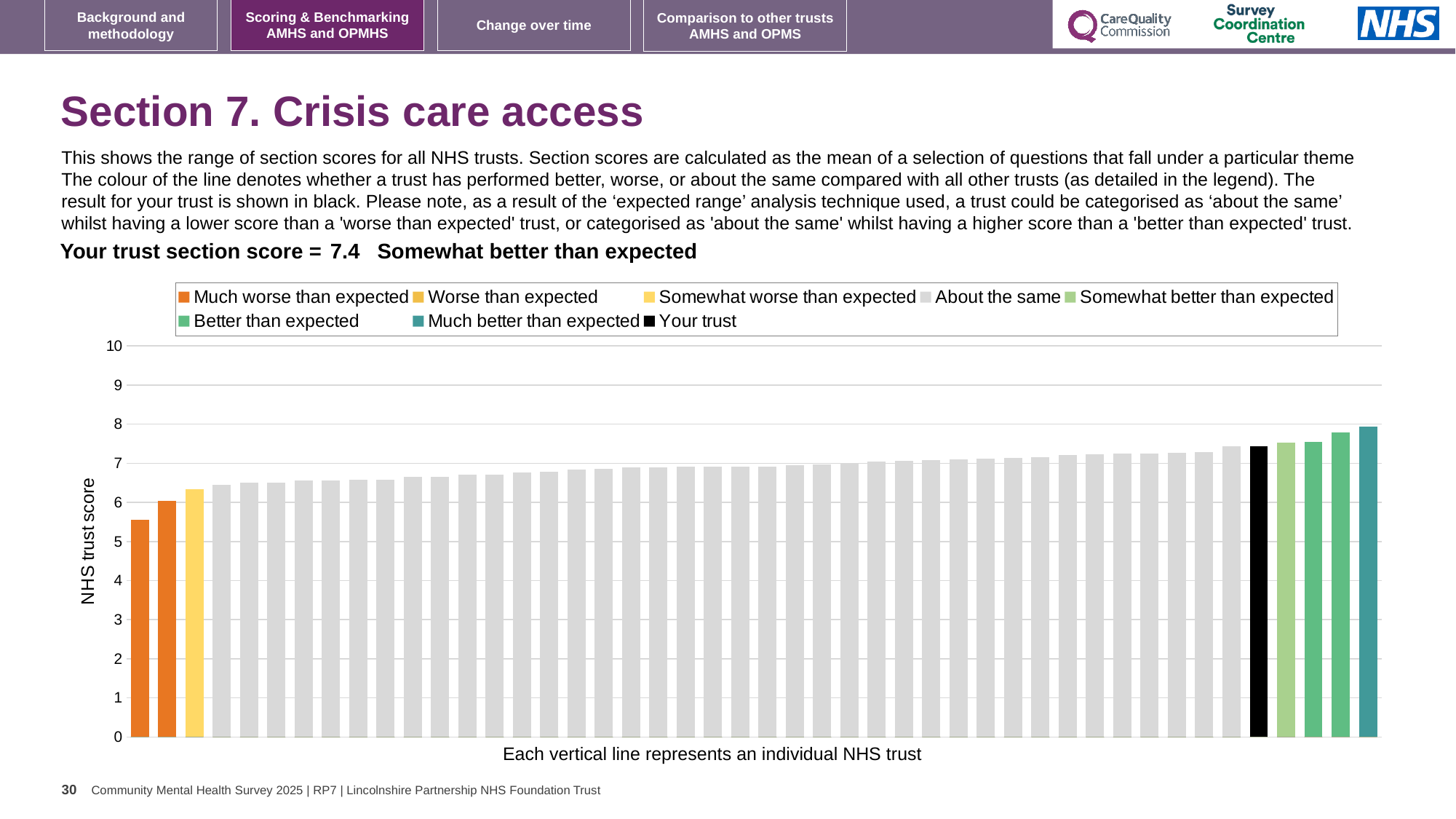
Which legend category does the lowest bar in the chart belong to? Much worse than expected Is the value of the lowest bar in the chart greater or less than 6? less Do the bar values rise or fall from left to right along the x axis? rise Which category is your trust placed in according to the slide? Somewhat better than expected Is the value of the highest bar in the chart greater or less than 8? less What is the section score for your trust shown on the slide? 7.4 How many entries does the chart legend list? 8 Which legend category does the highest bar in the chart belong to? Much better than expected Is the bar for your trust higher or lower than the 'Much better than expected' bar? lower What is the label on the vertical axis of the chart? NHS trust score Is the value for your trust (black bar) greater or less than 7? greater What kind of chart is shown on the slide? bar chart